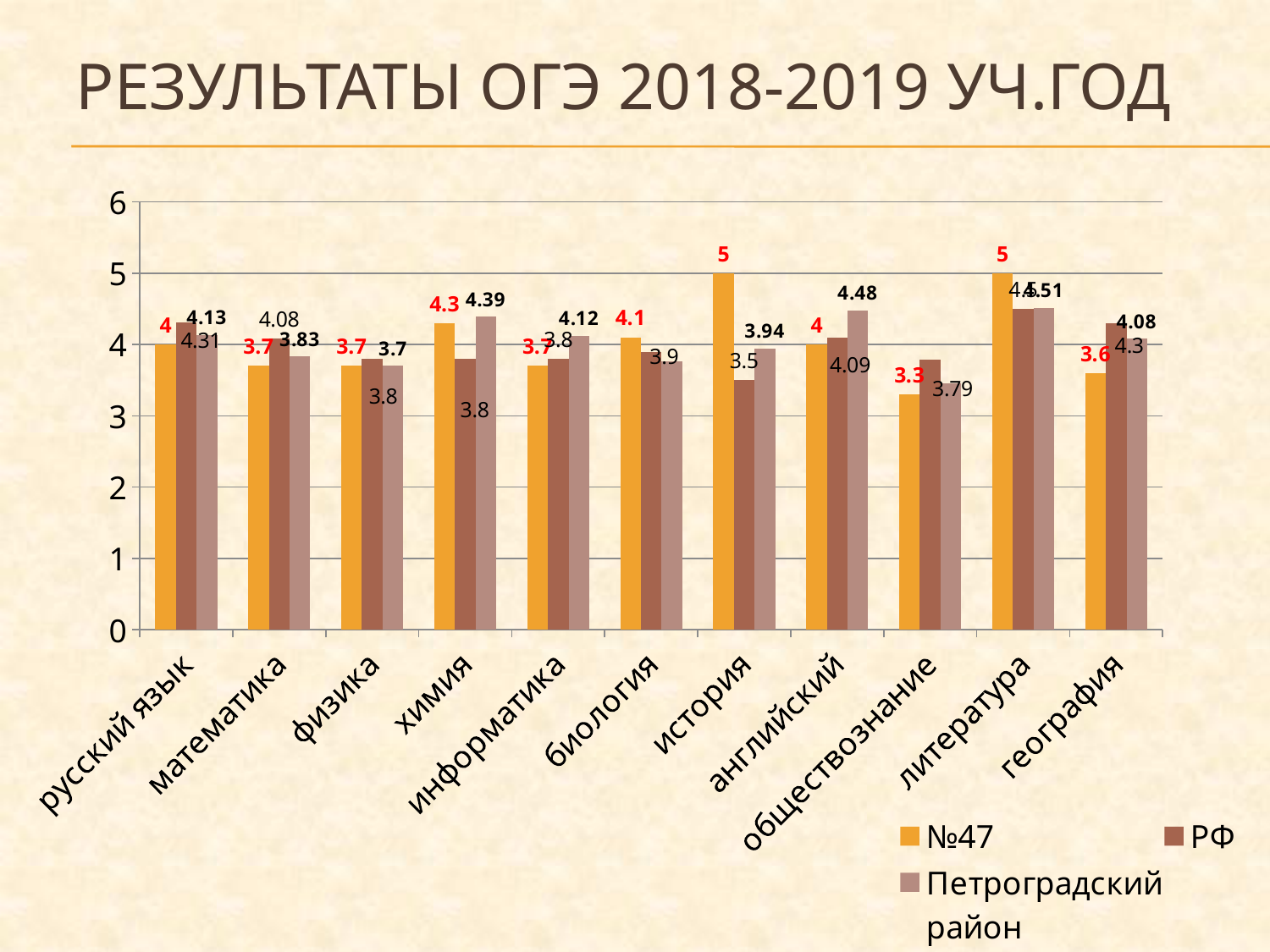
Is the value for РФ in история greater or less than 4? less What is the difference between the №47 value and the РФ value in история? 1.5 What is the value for Петроградский район in английский? 4.48 What is the value for №47 in история? 5 In история, which is larger: the value for №47 or the value for РФ? №47 Which subject has the lowest value for №47? обществознание How many subject categories are shown on the x axis? 11 What is the title of the chart? РЕЗУЛЬТАТЫ ОГЭ 2018-2019 УЧ.ГОД What is the value for РФ in русский язык? 4.31 What is the value for №47 in химия? 4.3 What kind of chart is shown on the slide? bar chart How many series does the legend list? 3